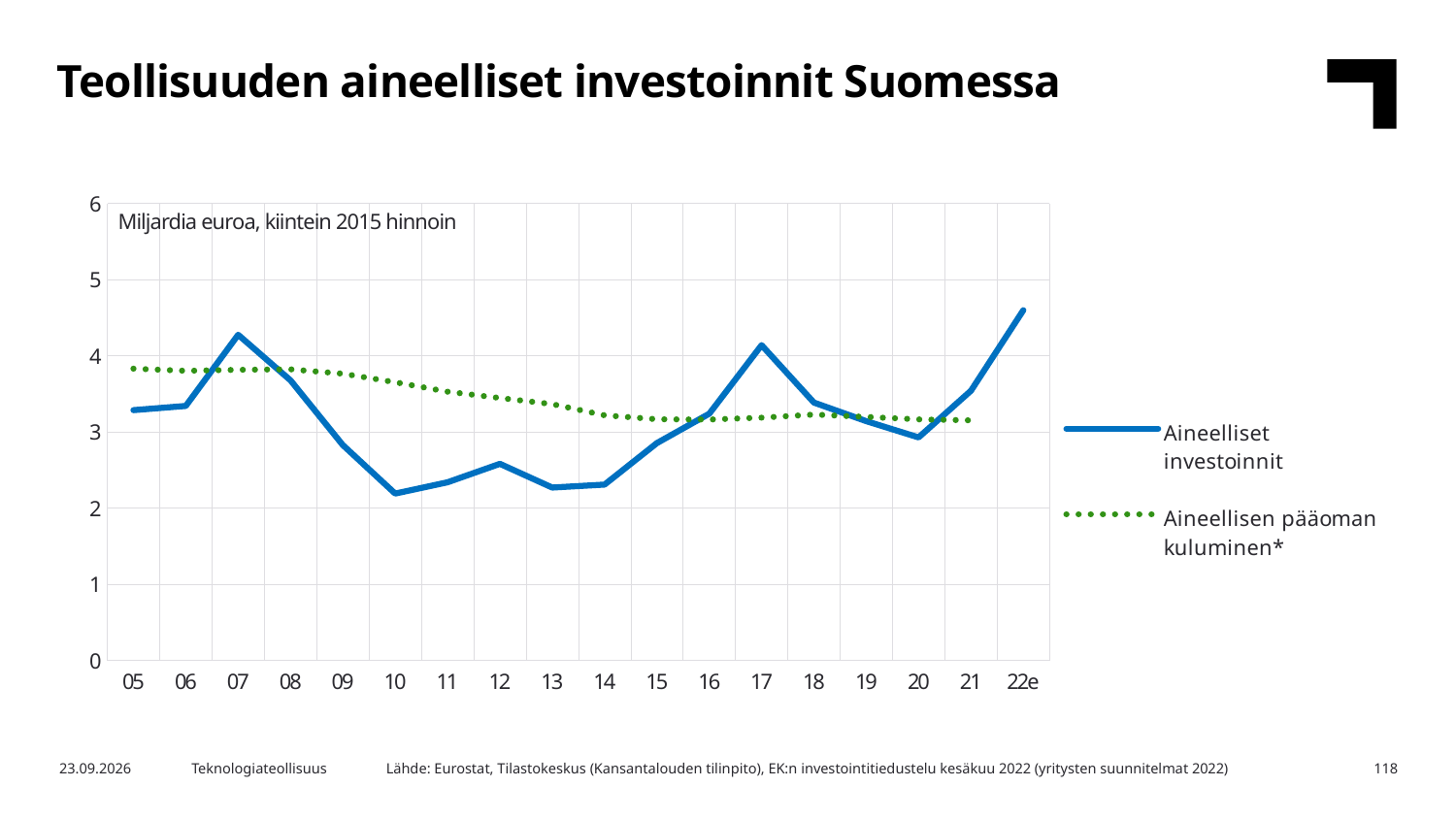
Is the value for Aineelliset investoinnit in 10 greater or less than 3? less What kind of chart is shown on the slide? line chart Is the value for Aineelliset investoinnit in 07 greater or less than 4? greater Does the Aineellisen pääoman kuluminen* line rise or fall from 05 to 15? fall In which year is the value for Aineelliset investoinnit highest? 22e Which is larger in 05: Aineelliset investoinnit or Aineellisen pääoman kuluminen*? Aineellisen pääoman kuluminen* How many years are shown on the x axis? 18 Is the value for Aineellisen pääoman kuluminen* in 05 greater or less than 3.5? greater How many series does the legend list? 2 What unit is stated in the text inside the chart area? Miljardia euroa, kiintein 2015 hinnoin Which year has the larger value for Aineelliset investoinnit: 07 or 09? 07